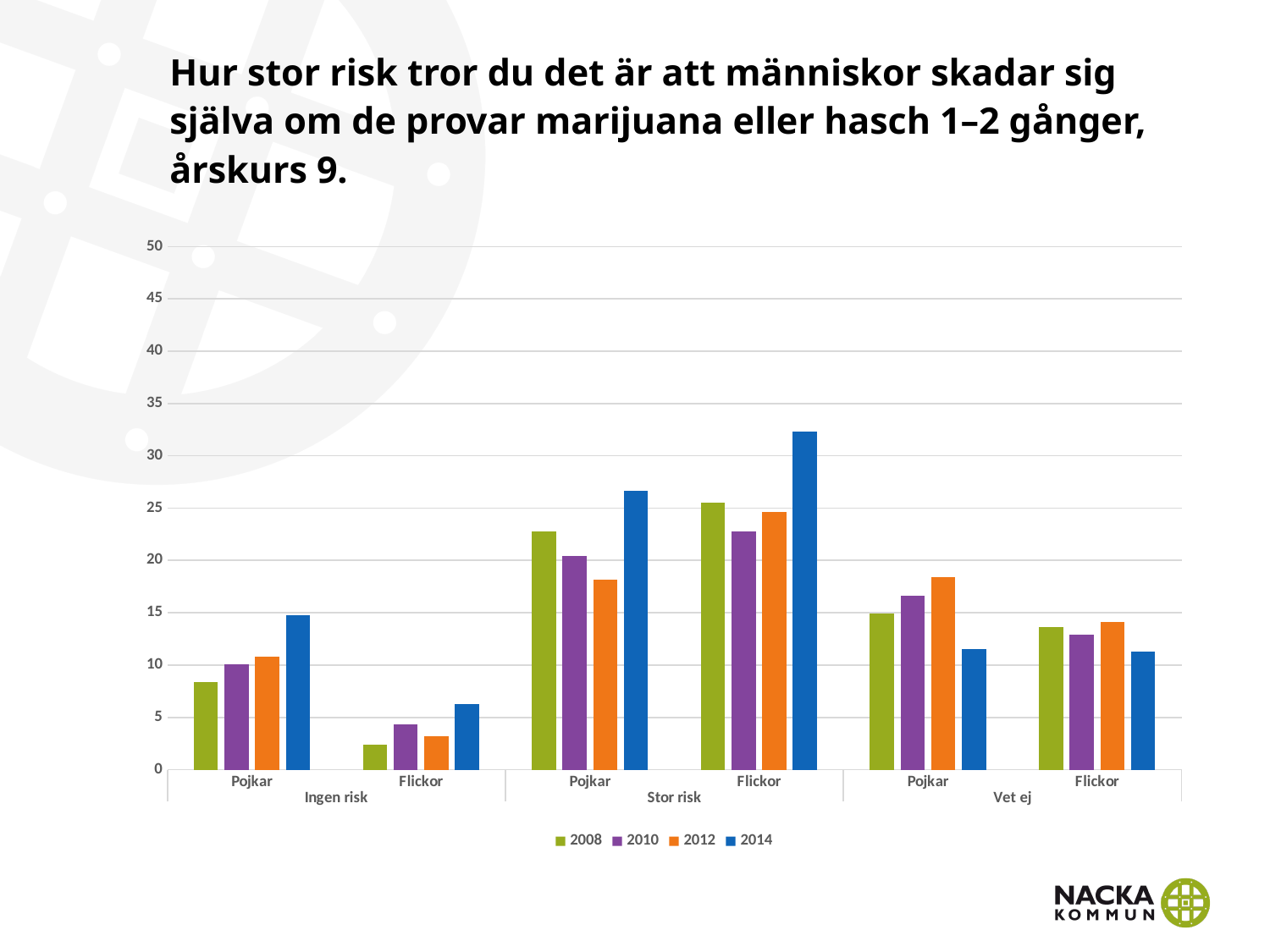
Is the 2008 value for Pojkar under Ingen risk greater or less than 10? less Is the 2014 value for Pojkar under Vet ej greater or less than 15? less Is the 2014 value for Flickor under Stor risk greater or less than 30? greater What kind of chart is shown on the slide? bar chart For Pojkar under Stor risk, which is larger: the 2008 value or the 2014 value? 2014 For Pojkar under Vet ej, which is larger: the 2012 value or the 2014 value? 2012 Which bar is the lowest in the whole chart? 2008, Flickor, Ingen risk How many main categories are shown along the x axis? 3 For Pojkar under Ingen risk, do the values rise or fall from 2008 to 2014? rise What are the entries in the legend? 2008, 2010, 2012, 2014 Which bar is the highest in the whole chart? 2014, Flickor, Stor risk How many series does the legend list? 4